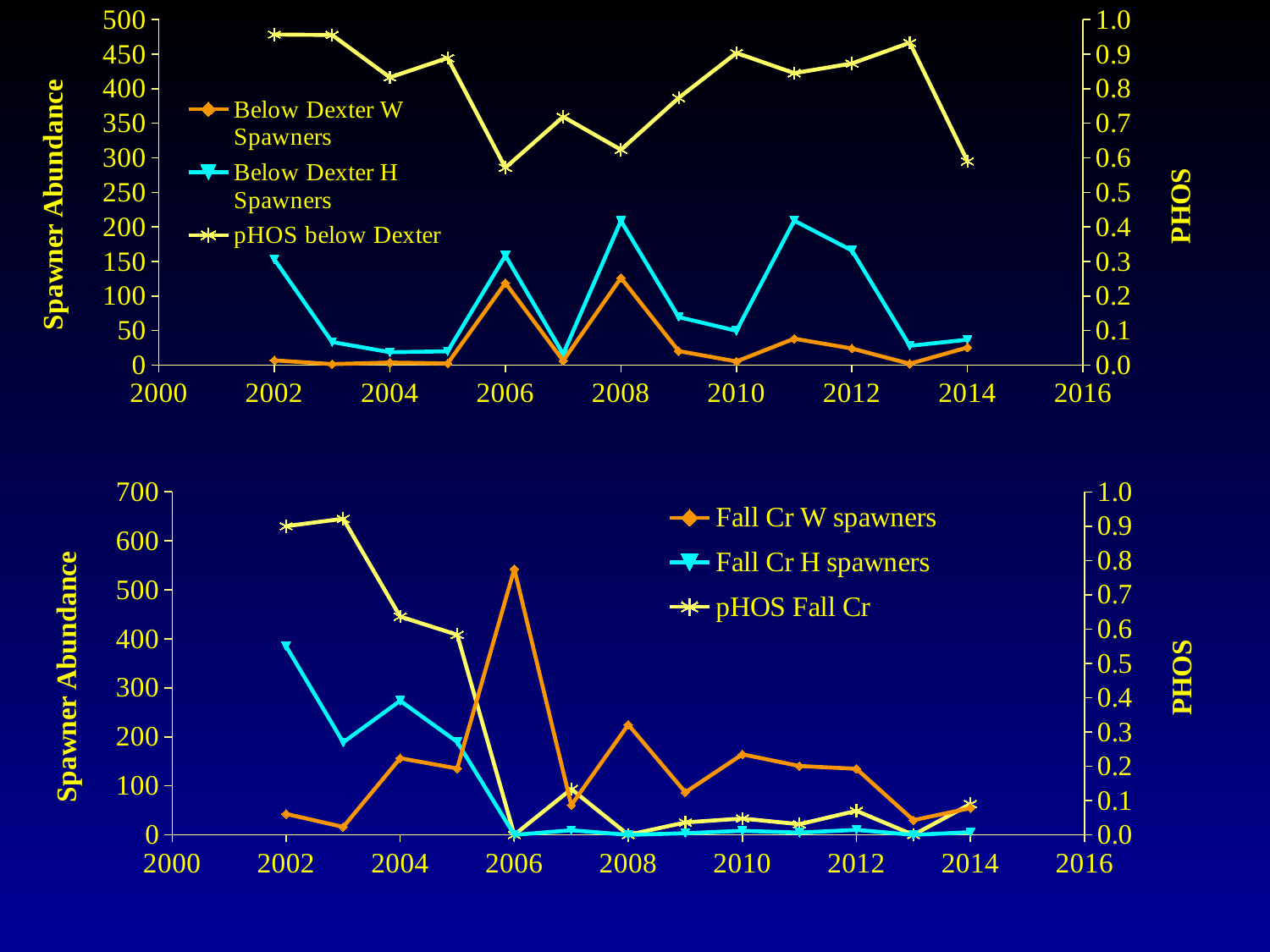
In the top chart, is the value for pHOS below Dexter in 2006 greater or less than 0.7? less What is the label of the right-hand vertical axis on the top chart? PHOS What kind of chart is the bottom chart? line chart In the bottom chart, does pHOS Fall Cr rise or fall from 2002 to 2008? fall In the bottom chart, which year has the highest value for Fall Cr W spawners? 2006 In the bottom chart, which year has the highest value for Fall Cr H spawners? 2002 In the top chart, is the value for Below Dexter H Spawners in 2008 greater or less than 150? greater In the bottom chart, is the value for pHOS Fall Cr in 2008 greater or less than 0.1? less How many series does the legend of the top chart list? 3 How many years are plotted for each series in the bottom chart? 13 In the top chart, which is larger in 2008: Below Dexter H Spawners or Below Dexter W Spawners? Below Dexter H Spawners